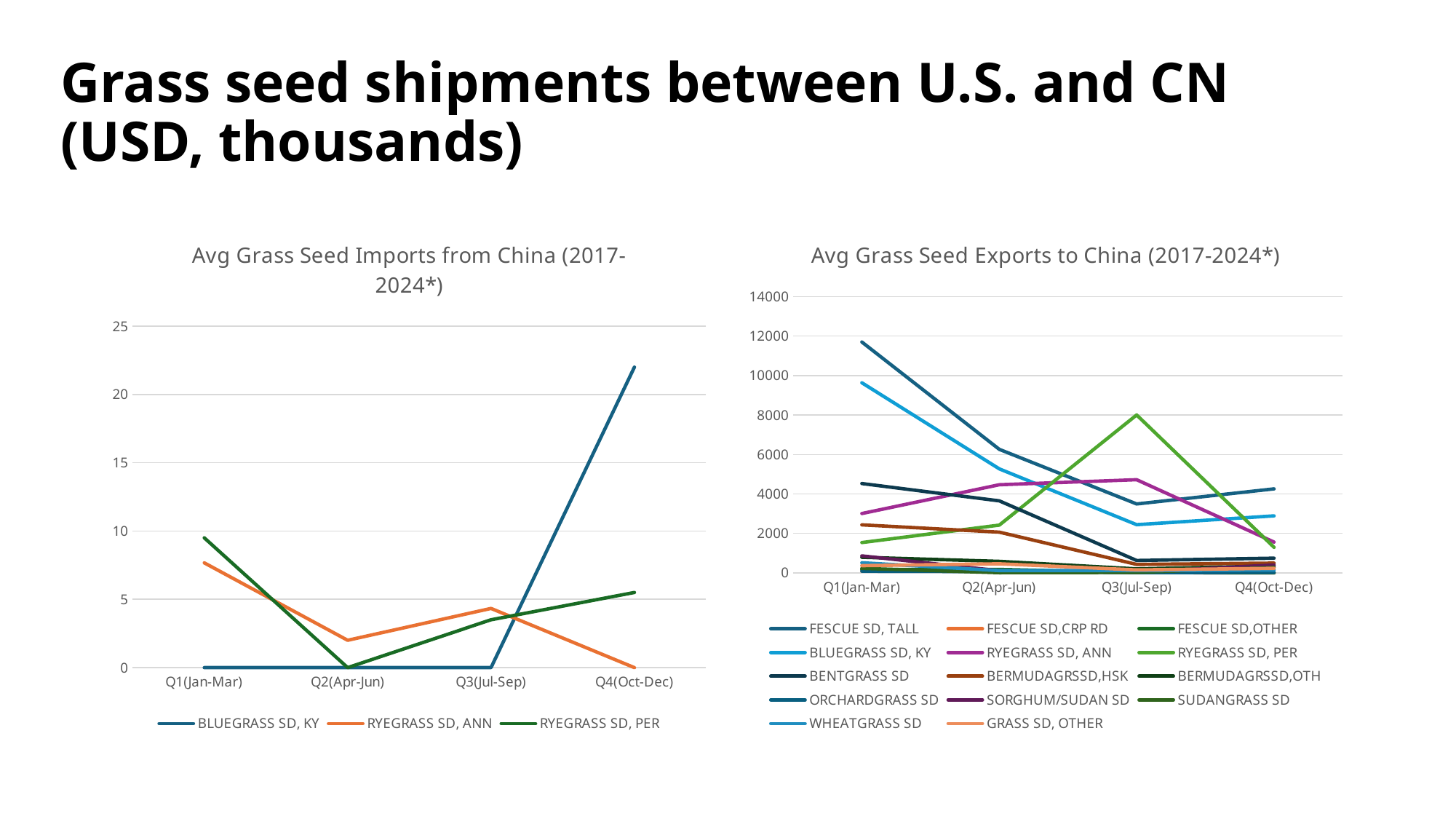
In "Avg Grass Seed Exports to China (2017-2024*)", which series has the highest value in Q3(Jul-Sep)? RYEGRASS SD, PER In "Avg Grass Seed Exports to China (2017-2024*)", does the value for FESCUE SD, TALL rise or fall from Q1(Jan-Mar) to Q3(Jul-Sep)? Fall In "Avg Grass Seed Imports from China (2017-2024*)", which series has the highest value in Q4(Oct-Dec)? BLUEGRASS SD, KY In "Avg Grass Seed Imports from China (2017-2024*)", is the value for BLUEGRASS SD, KY in Q4(Oct-Dec) greater or less than 20? greater In "Avg Grass Seed Imports from China (2017-2024*)", what is the value for BLUEGRASS SD, KY in Q2(Apr-Jun)? 0 In "Avg Grass Seed Imports from China (2017-2024*)", what is the value for RYEGRASS SD, ANN in Q4(Oct-Dec)? 0 How many series does the legend of "Avg Grass Seed Imports from China (2017-2024*)" list? 3 How many quarters are shown on the x axis of "Avg Grass Seed Imports from China (2017-2024*)"? 4 In "Avg Grass Seed Exports to China (2017-2024*)", is the value for FESCUE SD, TALL in Q1(Jan-Mar) greater or less than 10000? greater In "Avg Grass Seed Exports to China (2017-2024*)", which series has the highest value in Q1(Jan-Mar)? FESCUE SD, TALL What kind of chart is "Avg Grass Seed Imports from China (2017-2024*)"? Line chart How many series does the legend of "Avg Grass Seed Exports to China (2017-2024*)" list? 14